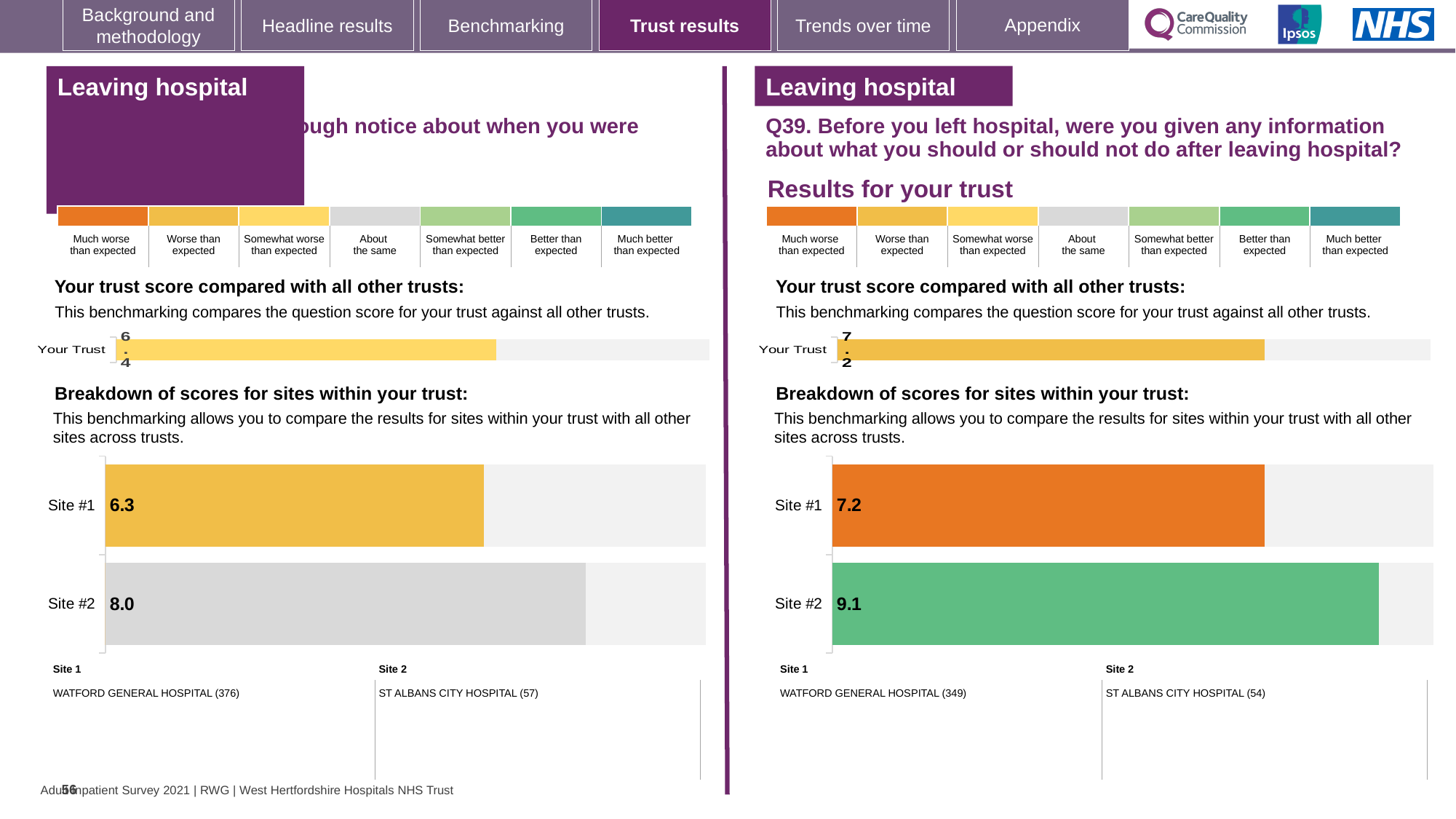
In the site breakdown chart on the left-hand side of the slide, what is the difference between the Site #2 and Site #1 scores? 1.7 In the 'Your Trust' chart on the left-hand side of the slide, what is the trust score? 6.4 In the site breakdown chart on the left-hand side of the slide, what is the score for Site #1? 6.3 In the site breakdown chart on the left-hand side of the slide, which site has the higher score? Site #2 In the site breakdown chart for Q39 on the right-hand side of the slide, what is the score for Site #1? 7.2 In the site breakdown chart for Q39 on the right-hand side of the slide, which site has the lower score? Site #1 In the site breakdown chart for Q39 on the right-hand side of the slide, what is the score for Site #2? 9.1 In the site breakdown chart on the left-hand side of the slide, what is the score for Site #2? 8.0 In the site breakdown chart for Q39 on the right-hand side of the slide, what is the difference between the Site #2 and Site #1 scores? 1.9 What type of chart is used for the site breakdown on the left-hand side of the slide? Bar chart How many sites are shown in the site breakdown chart for Q39 on the right-hand side of the slide? 2 In the 'Your Trust' chart for Q39 on the right-hand side of the slide, what is the trust score? 7.2